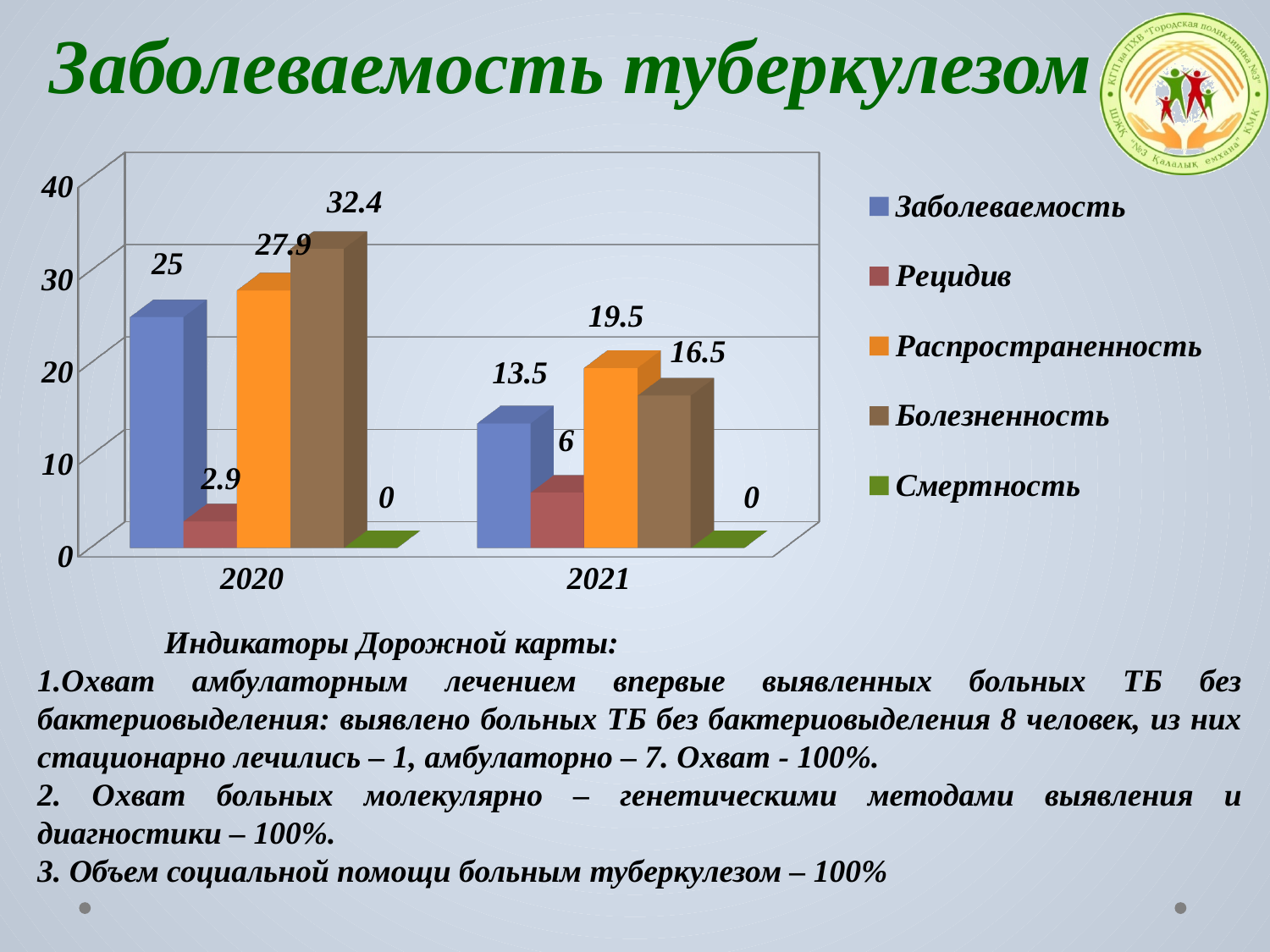
What is the value for Болезненность in 2021? 16.5 Which is larger: Заболеваемость in 2020 or Заболеваемость in 2021? Заболеваемость in 2020 What kind of chart is shown on the slide? Bar chart What is the difference between Распространенность in 2020 and in 2021? 8.4 What is the value for Заболеваемость in 2020? 25 How many series does the legend list? 5 Which series has the highest value in 2021? Распространенность What is the value for Рецидив in 2021? 6 Does the value for Рецидив rise or fall from 2020 to 2021? Rise How many categories are shown on the x axis? 2 What is the value for Смертность in 2020? 0 Which series has the highest value in 2020? Болезненность